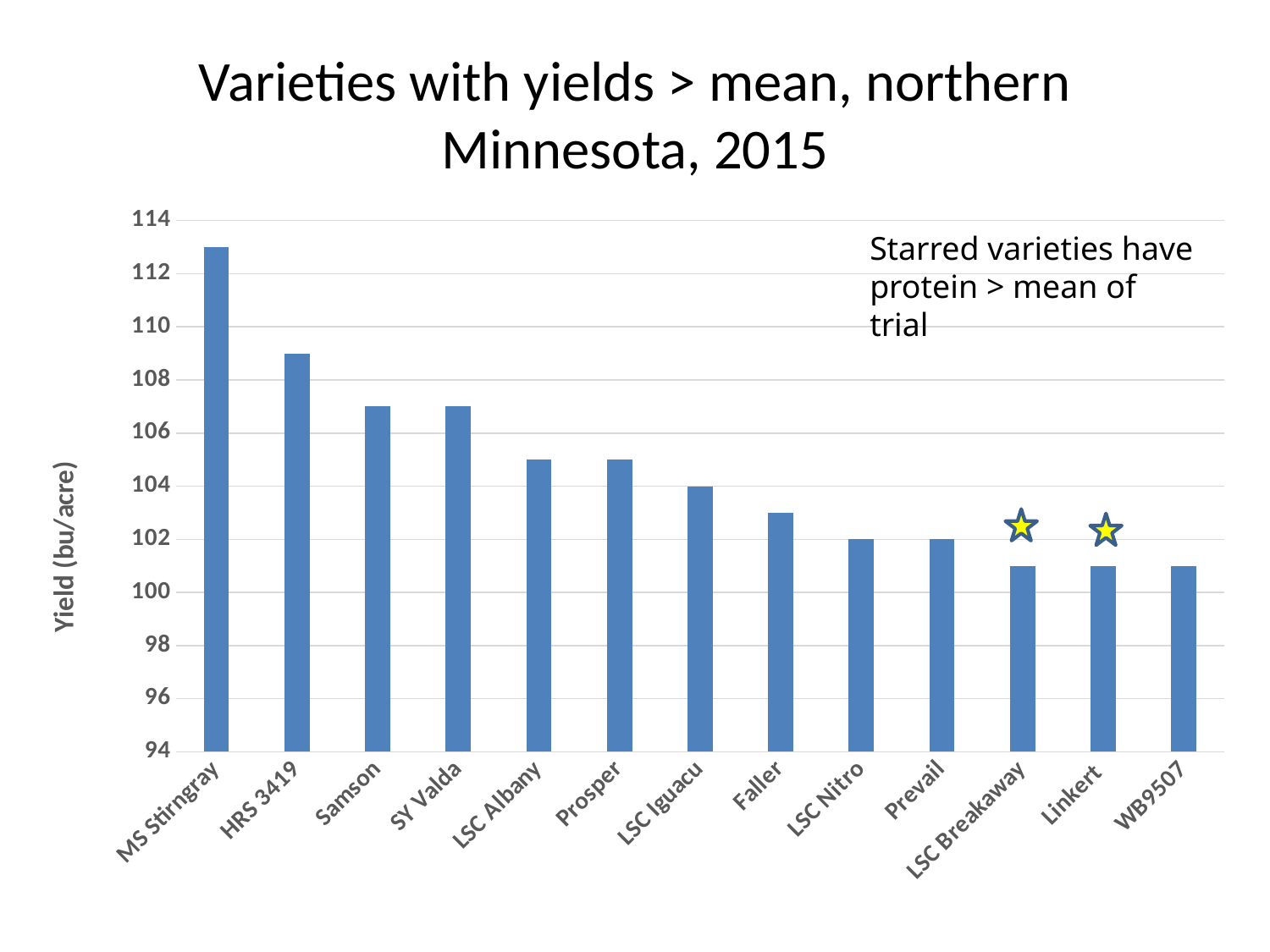
Is the yield for HRS 3419 greater or less than 108? greater Which variety has the highest yield in the chart? MS Stirngray What type of chart is shown on the slide? bar chart Is the yield for LSC Albany greater or less than 106? less Is the yield for WB9507 greater or less than 100? greater Which has the larger yield, HRS 3419 or Samson? HRS 3419 How many varieties are plotted in the chart? 13 What is the label on the vertical axis of the chart? Yield (bu/acre) Do the yields rise or fall moving from left to right along the x axis? fall Which varieties are marked with a star in the chart? LSC Breakaway and Linkert